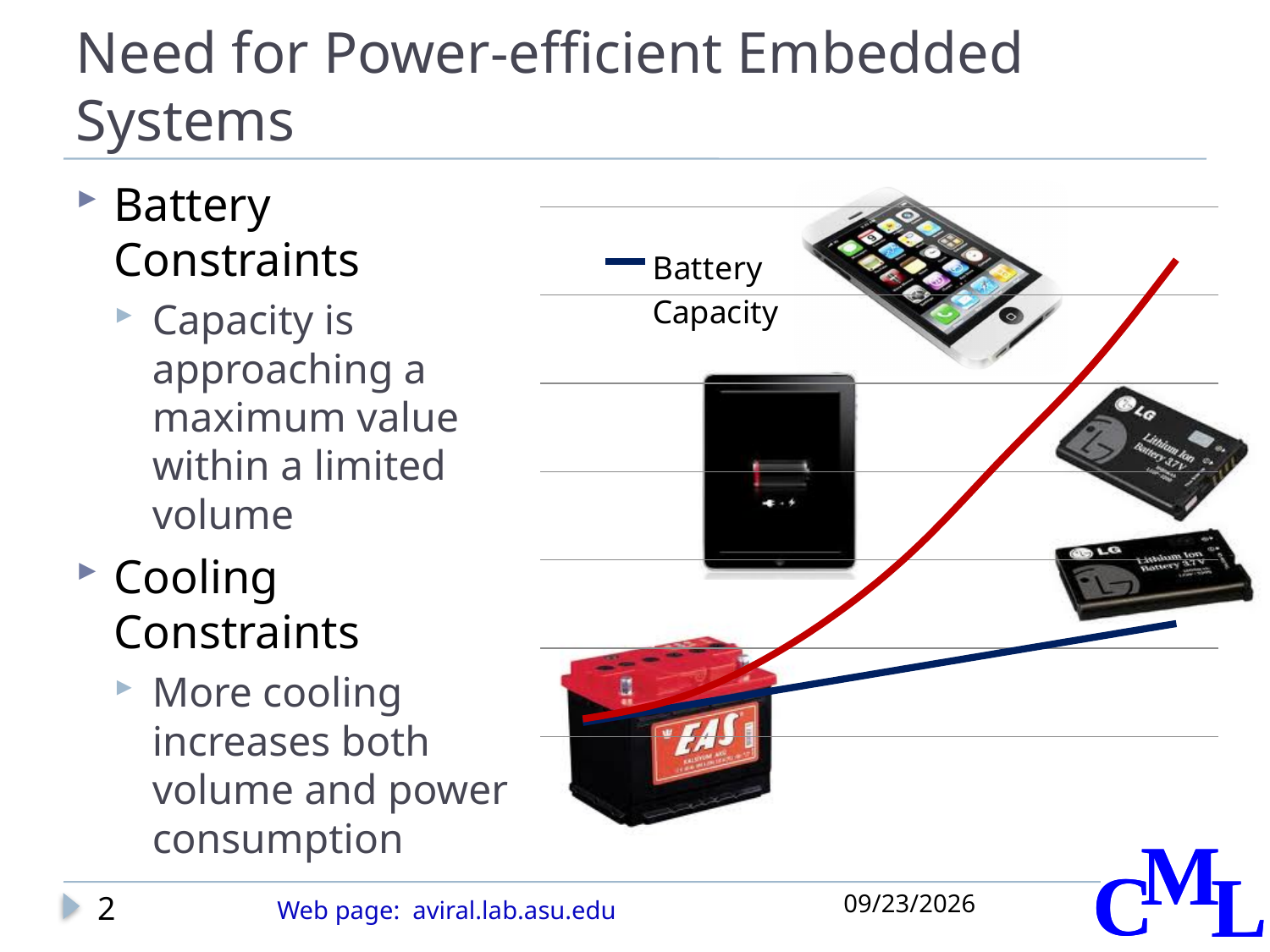
What colour is the Battery Capacity line in the chart? dark blue What is the name of the series listed in the chart's legend? Battery Capacity Does the Battery Capacity line rise or fall from left to right? rise At the right end of the chart, which line is higher, the red line or the Battery Capacity line? the red line Which line rises more steeply across the chart, the red line or the Battery Capacity line? the red line Does the red line in the chart rise or fall from left to right? rise How many series does the chart's legend list? 1 What kind of chart is shown on the right side of the slide? line chart